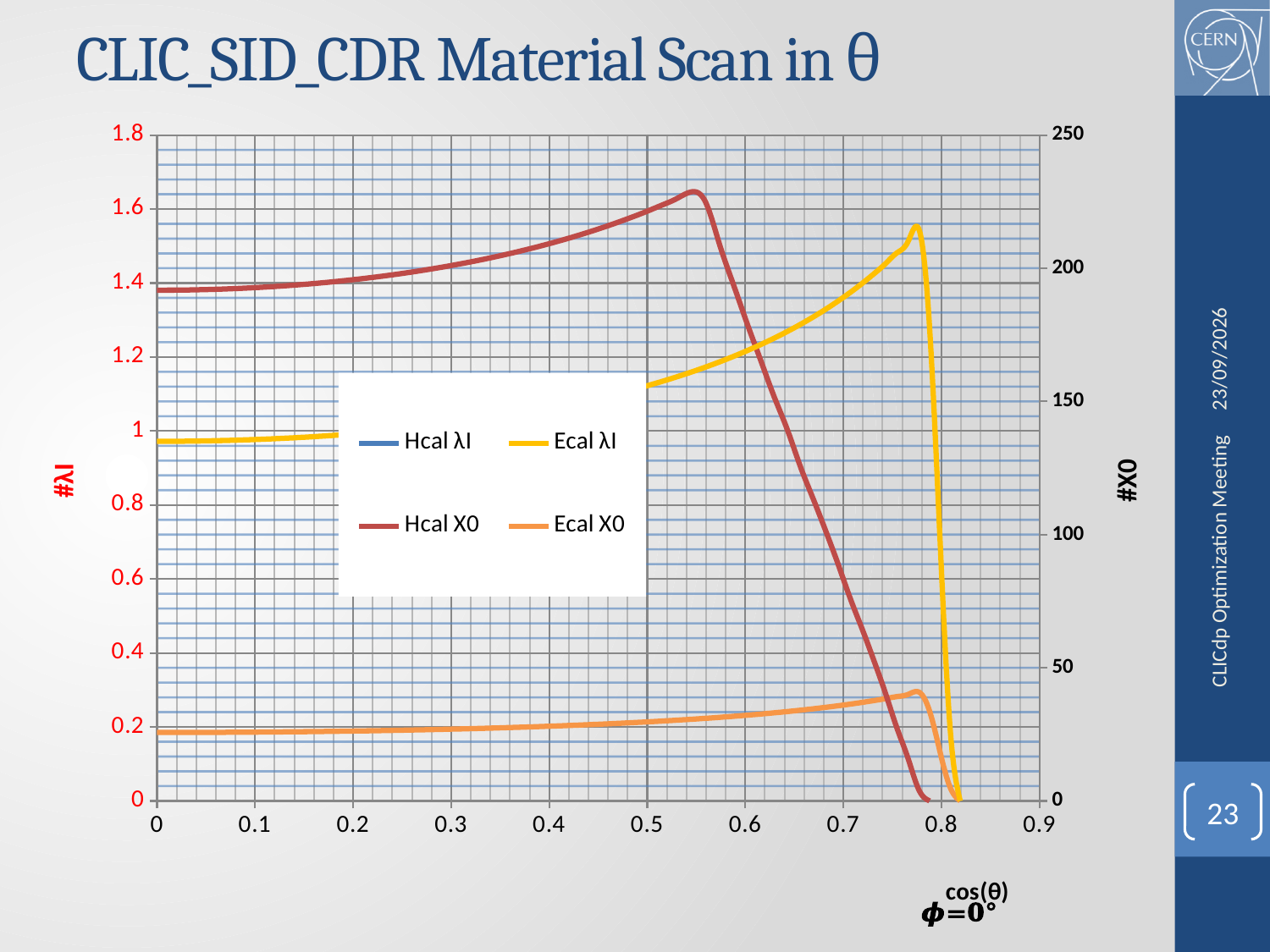
Does the Hcal X0 curve rise or fall as cos(θ) goes from 0 to 0.5? rise Is the peak value of Ecal λI (near cos(θ) = 0.78) greater or less than 1.4 on the left axis? greater At cos(θ) = 0.3, which series is higher on the chart: Hcal X0 or Ecal X0? Hcal X0 Is the peak value of Hcal X0 (near cos(θ) = 0.55) greater or less than 200 on the right axis? greater What kind of chart is shown on the slide? line chart How many series does the chart legend list? 4 What is the title of the chart slide? CLIC_SID_CDR Material Scan in θ What is the label of the right-hand vertical axis? #X0 Is the value of Ecal X0 at cos(θ) = 0 greater or less than 50 on the right axis? less Does the Hcal X0 curve rise or fall as cos(θ) goes from 0.6 to 0.8? fall